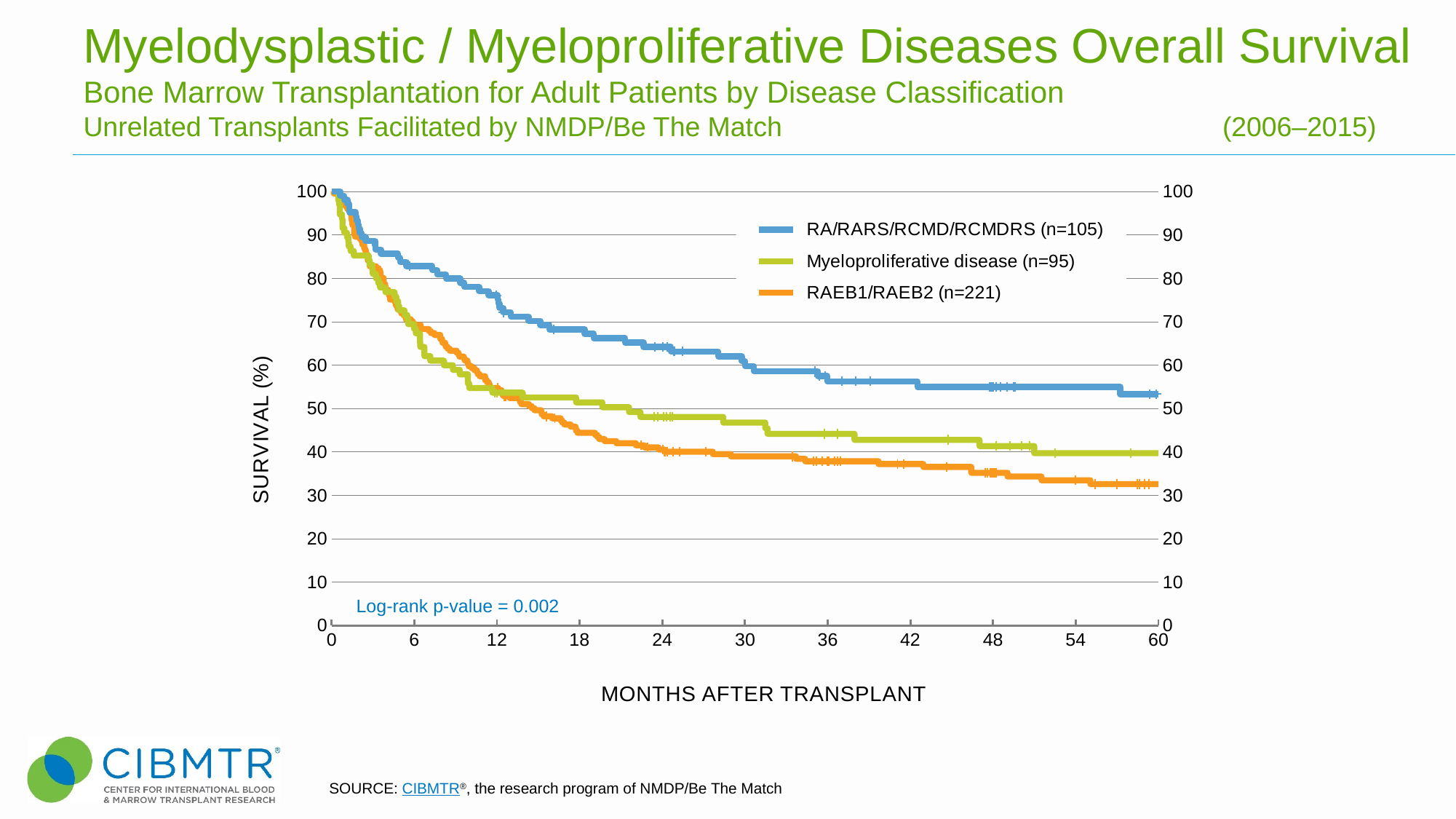
Is the survival for RA/RARS/RCMD/RCMDRS at 60 months greater or less than 50? greater Which series has the lowest survival at 60 months after transplant? RAEB1/RAEB2 (n=221) Is the survival for RAEB1/RAEB2 at 60 months greater or less than 40? less Is the survival for RA/RARS/RCMD/RCMDRS at 24 months greater or less than 60? greater How many patients (n) are in the RAEB1/RAEB2 group according to the legend? 221 Which series has the highest survival at 60 months after transplant? RA/RARS/RCMD/RCMDRS (n=105) Do the survival curves rise or fall as months after transplant increase? Fall At 48 months after transplant, which series has higher survival: Myeloproliferative disease or RAEB1/RAEB2? Myeloproliferative disease What is the log-rank p-value shown on the chart? 0.002 How many series does the legend list? 3 What kind of chart is shown on the slide? Line chart